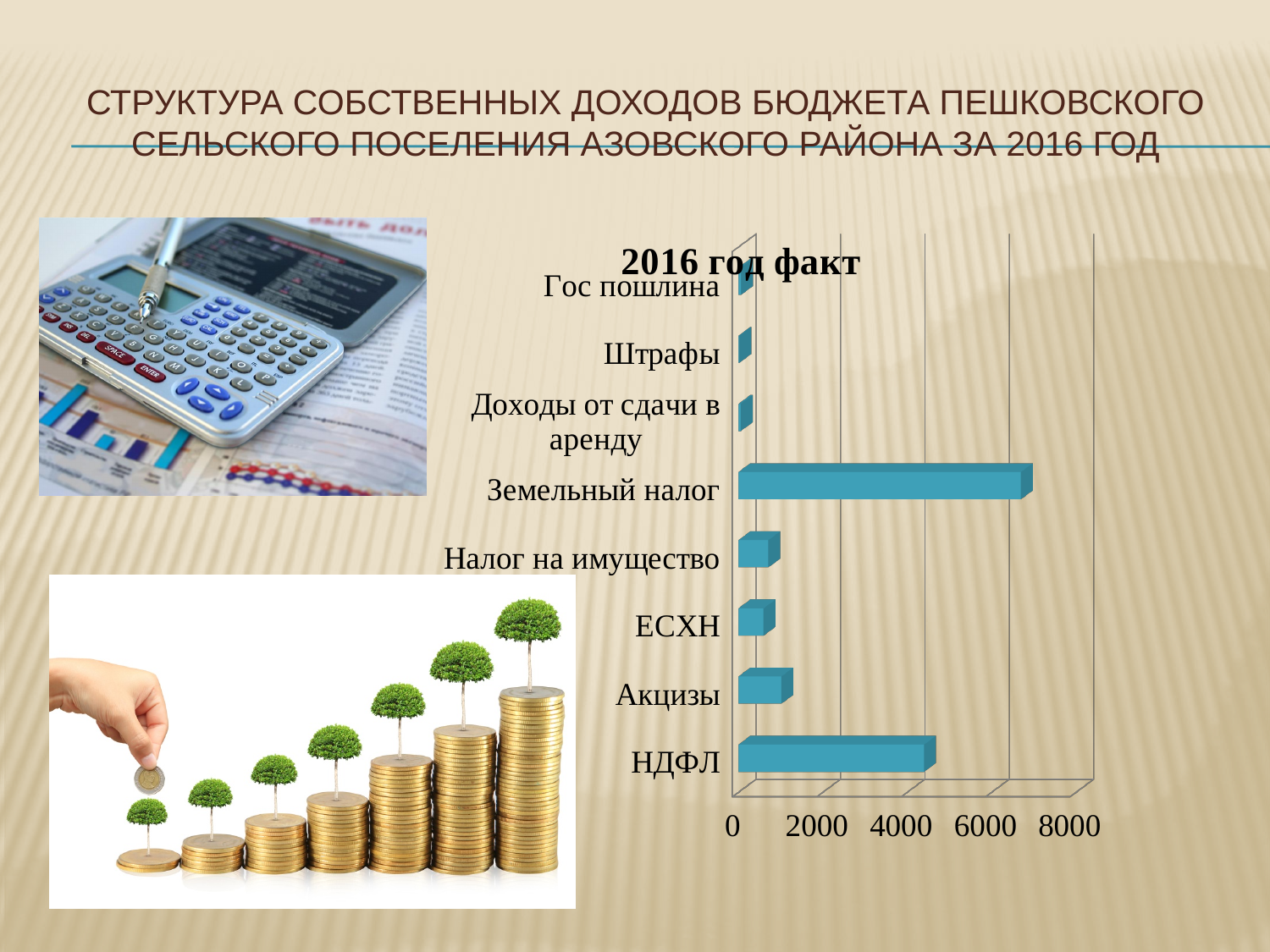
What is the title of the chart? 2016 год факт Is the value for НДФЛ greater or less than 6000? less How many categories are plotted in the chart? 8 Is the value for Налог на имущество greater or less than 2000? less Which is larger, the value for НДФЛ or the value for Акцизы? НДФЛ Is the value for Акцизы greater or less than 2000? less Which is larger, the value for Земельный налог or the value for НДФЛ? Земельный налог Which category has the highest value in the chart? Земельный налог What kind of chart is shown on the slide? bar chart